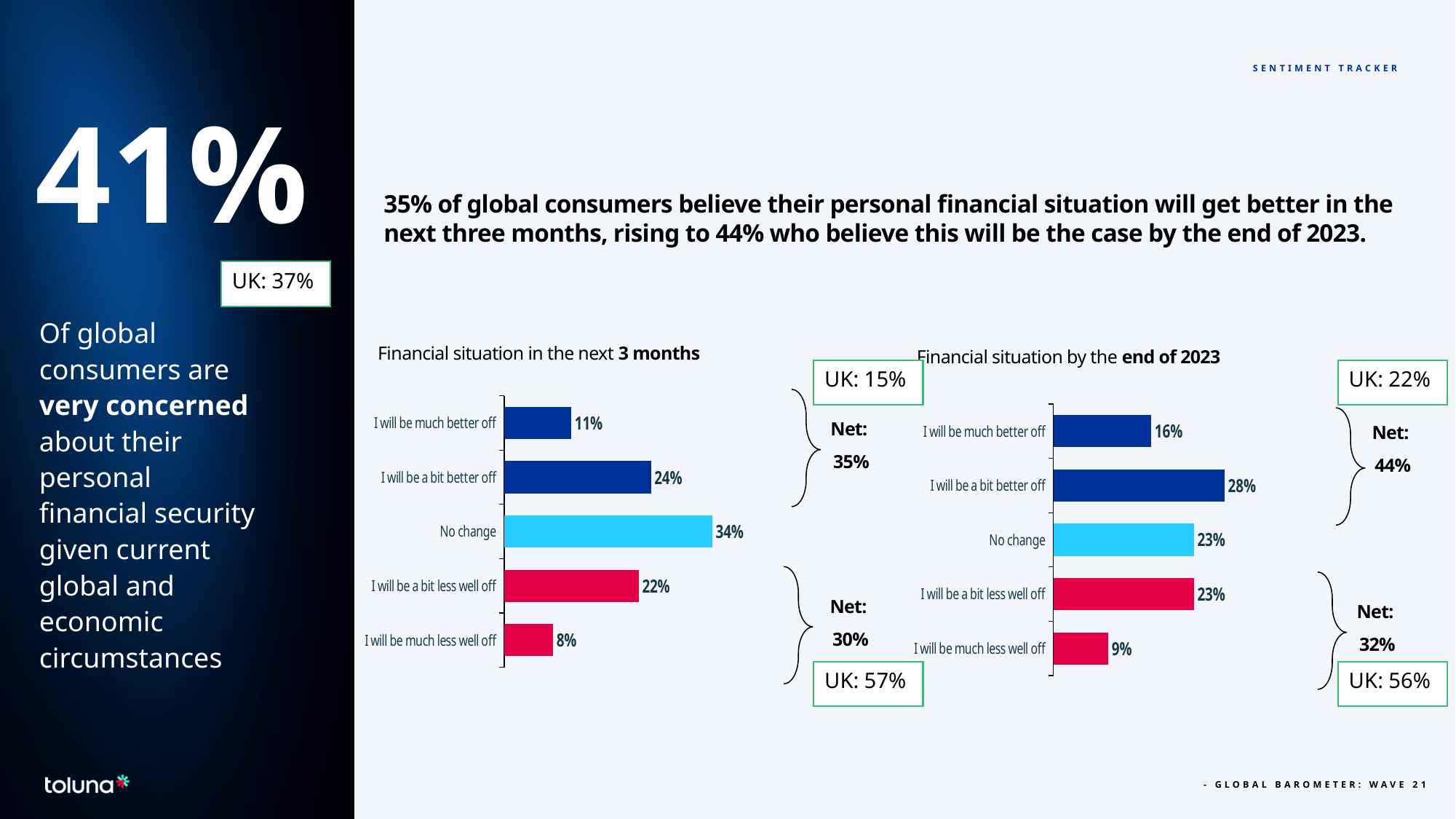
What colour are the 'No change' bars in both charts? Light blue In the 'Financial situation in the next 3 months' chart, what is the Net value shown for the two 'better off' categories combined? 35% In the 'Financial situation by the end of 2023' chart, what is the difference between 'I will be a bit less well off' and 'I will be much less well off'? 14% What kind of chart is the 'Financial situation by the end of 2023' chart? Bar chart In the 'Financial situation in the next 3 months' chart, what is the difference between 'I will be a bit better off' and 'I will be much better off'? 13% In the 'Financial situation by the end of 2023' chart, what is the value for 'I will be a bit better off'? 28% In the 'Financial situation in the next 3 months' chart, what is the value for 'No change'? 34% In the 'Financial situation in the next 3 months' chart, what is the value for 'I will be much less well off'? 8% In the 'Financial situation by the end of 2023' chart, which is larger: 'I will be much better off' or 'I will be much less well off'? I will be much better off In the 'Financial situation in the next 3 months' chart, which category has the highest value? No change How many categories are shown in the 'Financial situation in the next 3 months' chart? 5 In the 'Financial situation by the end of 2023' chart, which category has the lowest value? I will be much less well off